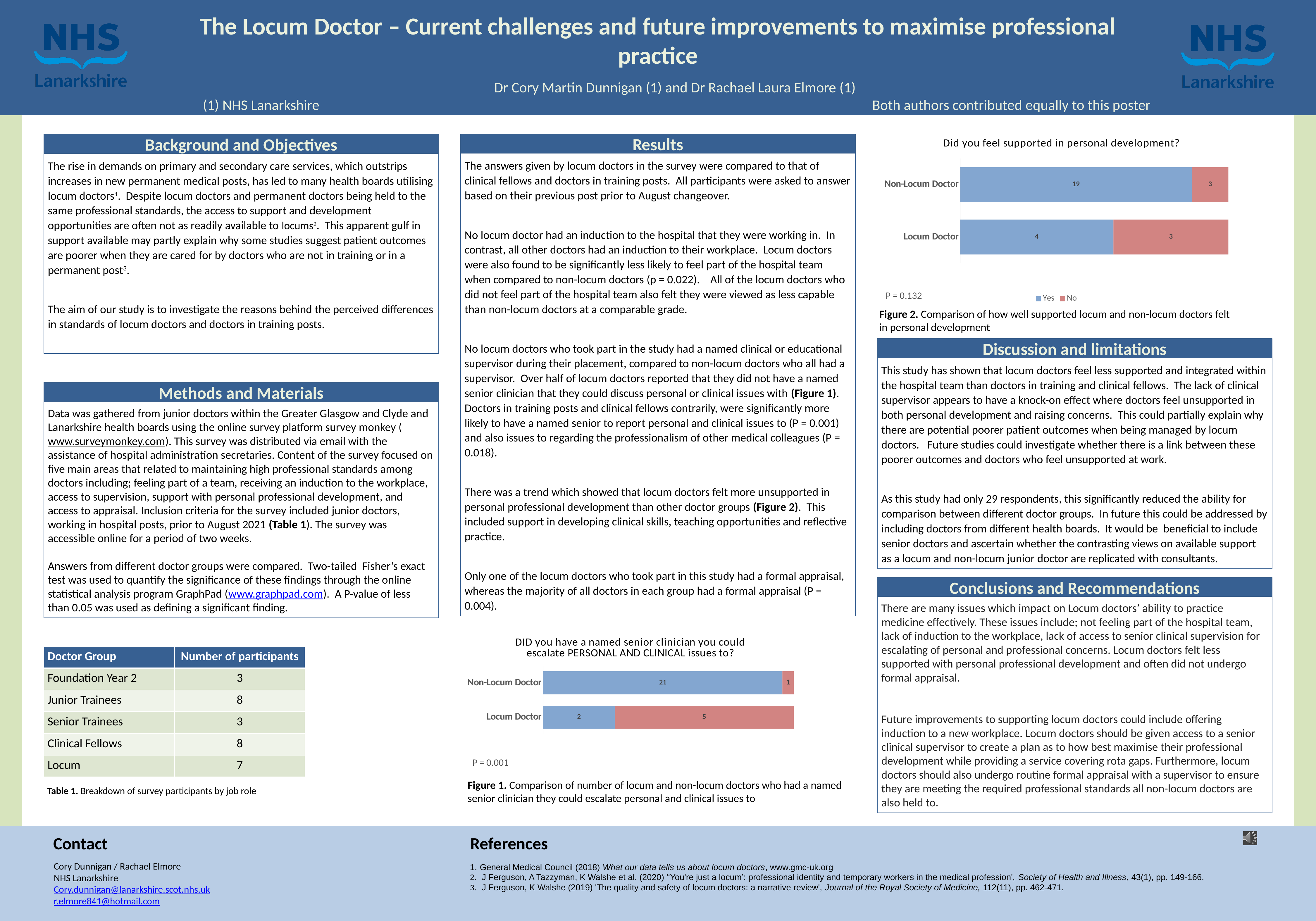
In the chart titled "DID you have a named senior clinician you could escalate PERSONAL AND CLINICAL issues to?", which doctor group has the larger number of No responses? Locum Doctor In the chart titled "Did you feel supported in personal development?", what is the total number of Locum Doctor responses shown in the stacked bar? 7 In the chart titled "Did you feel supported in personal development?", how many Non-Locum Doctors answered Yes? 19 In the chart titled "Did you feel supported in personal development?", how many series does the legend list? 2 In the chart titled "Did you feel supported in personal development?", how many Locum Doctors answered No? 3 In the chart titled "DID you have a named senior clinician you could escalate PERSONAL AND CLINICAL issues to?", how many Non-Locum Doctors answered Yes? 21 In the chart titled "DID you have a named senior clinician you could escalate PERSONAL AND CLINICAL issues to?", how many doctor groups are shown? 2 In the chart titled "Did you feel supported in personal development?", what type of chart is used? Stacked bar chart In the chart titled "DID you have a named senior clinician you could escalate PERSONAL AND CLINICAL issues to?", how many Locum Doctors answered No? 5 In the chart titled "DID you have a named senior clinician you could escalate PERSONAL AND CLINICAL issues to?", what is the difference between the number of Non-Locum Doctors and Locum Doctors who answered Yes? 19 In the chart titled "Did you feel supported in personal development?", what P value is shown? P = 0.132 In the chart titled "Did you feel supported in personal development?", what is the total number of Non-Locum Doctor responses shown in the stacked bar? 22